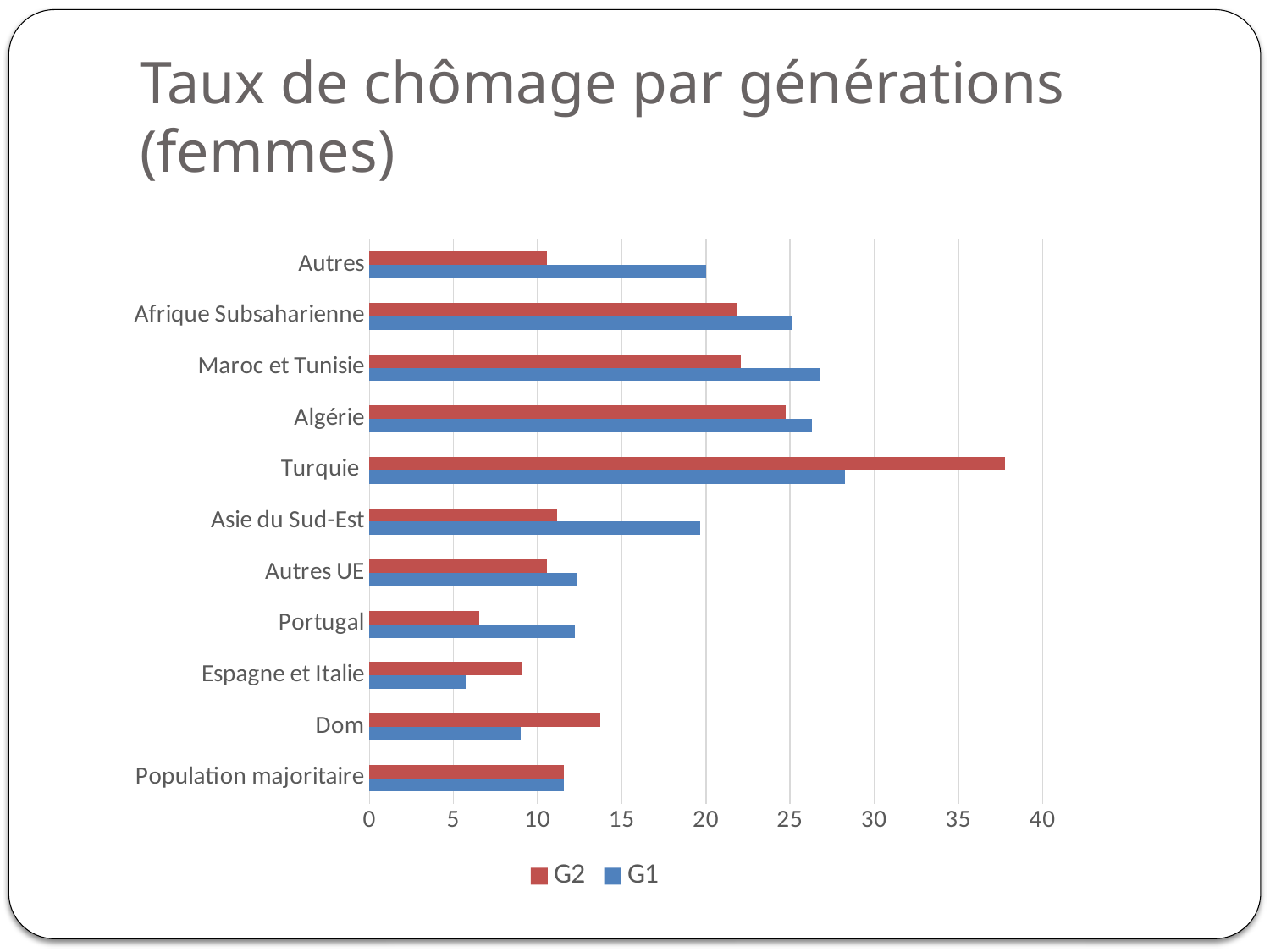
Which category has the lowest G1 value? Espagne et Italie What is the title of the chart? Taux de chômage par générations (femmes) For Asie du Sud-Est, which series has the larger value, G1 or G2? G1 Which category has the highest G1 value? Turquie Is the G2 value for Portugal greater or less than 10? less Is the G1 value for Autres greater or less than 15? greater Which category has the highest G2 value? Turquie How many categories are shown on the chart? 11 What kind of chart is shown on the slide? bar chart Is the G2 value for Turquie greater or less than 35? greater Which category has the lowest G2 value? Portugal How many series does the legend list? 2